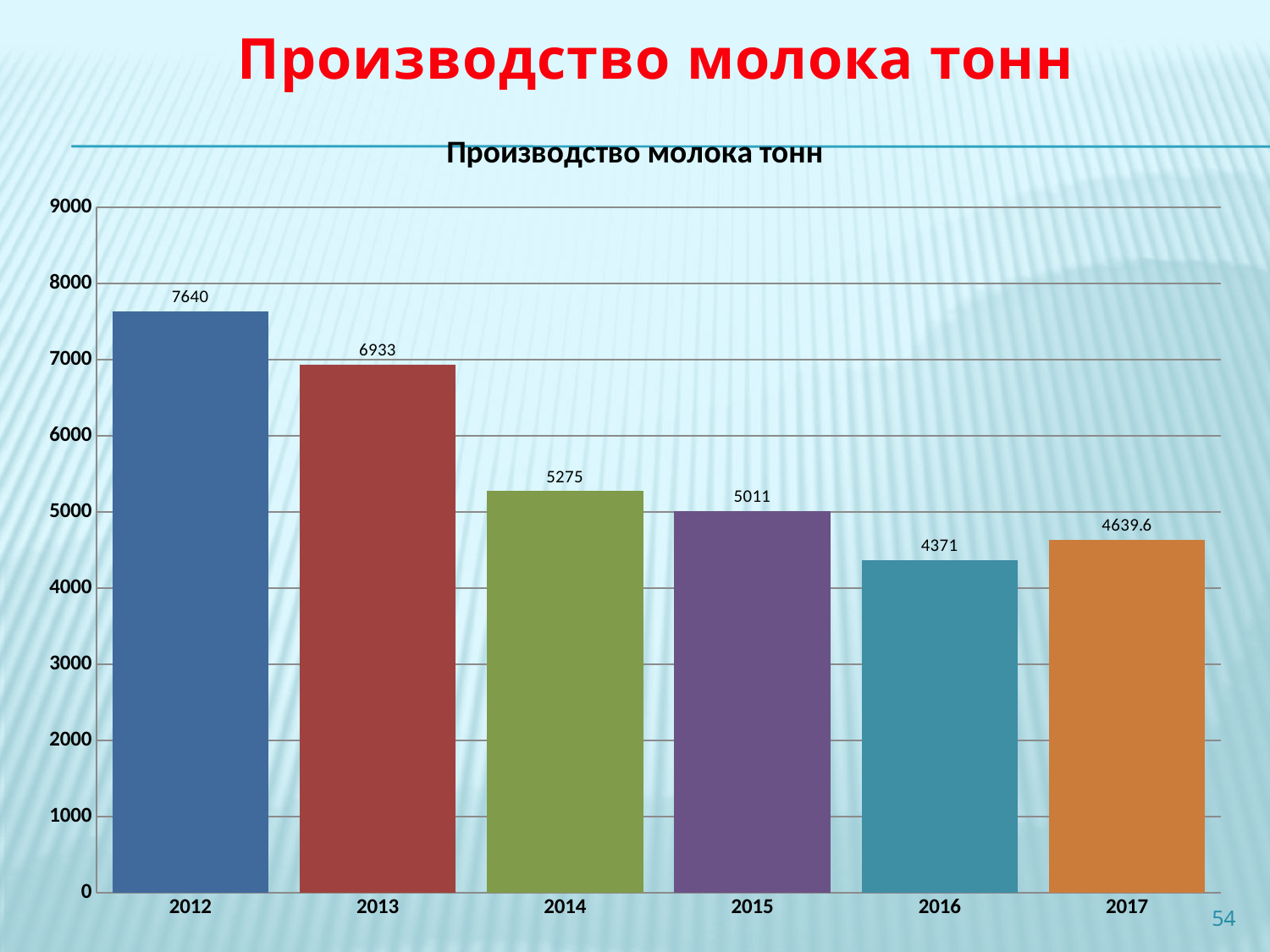
What is the milk production value for 2012? 7640 What kind of chart is shown on the slide? Bar chart What is the title of the chart? Производство молока тонн Which year has a larger milk production value, 2016 or 2017? 2017 What is the milk production value for 2014? 5275 Which year has the lowest milk production? 2016 How many years are shown on the chart? 6 Which year has the highest milk production? 2012 What is the difference between the milk production in 2014 and 2015? 264 What is the difference between the milk production in 2012 and 2013? 707 What is the milk production value for 2017? 4639.6 Is the value for 2015 greater or less than 6000? less